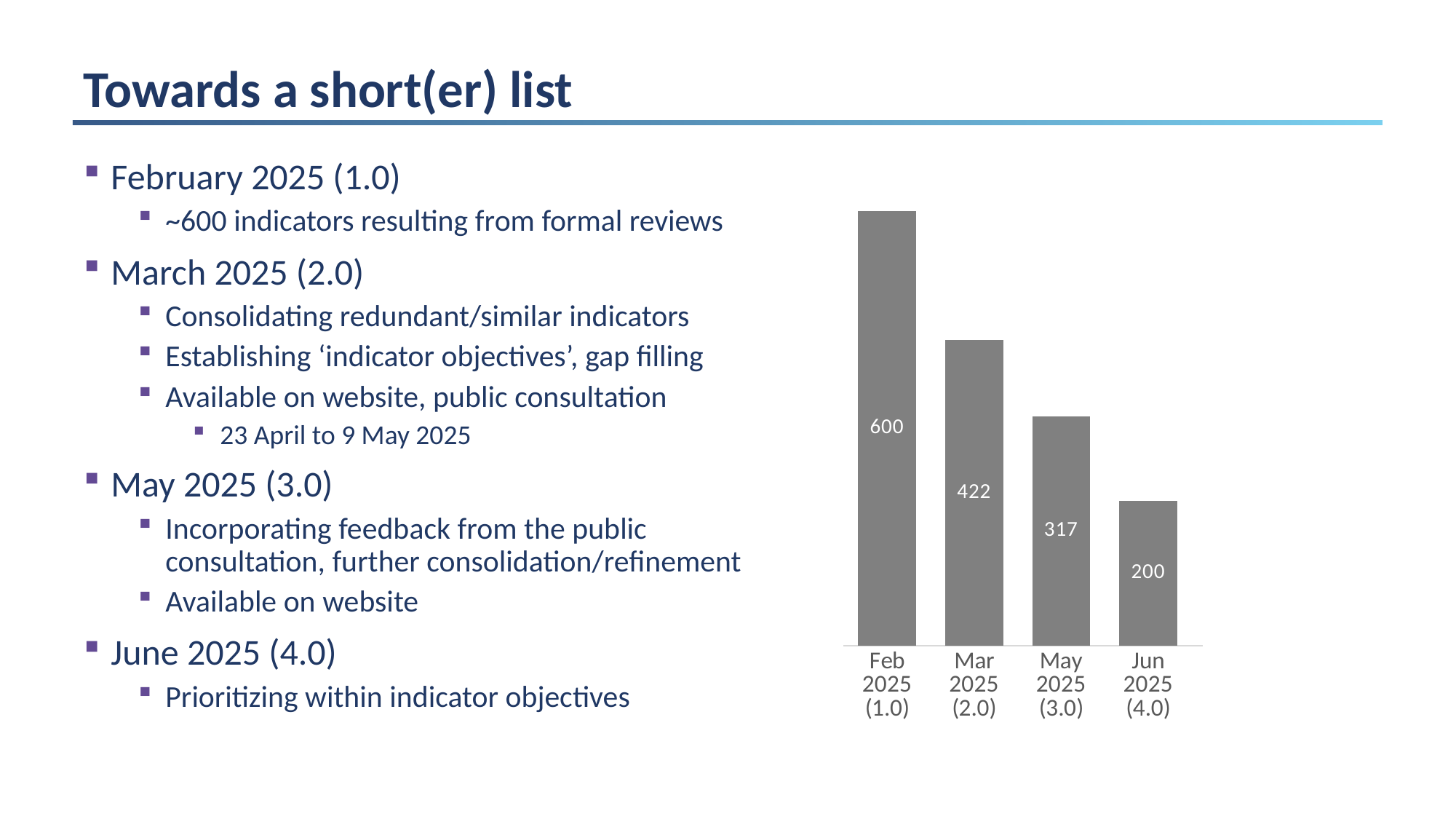
How many categories are shown on the x axis? 4 What is the value for Jun 2025 (4.0)? 200 What is the value for Mar 2025 (2.0)? 422 Do the values rise or fall from Feb 2025 to Jun 2025? Fall Which category has the highest value? Feb 2025 (1.0) What is the difference between the values for Mar 2025 (2.0) and May 2025 (3.0)? 105 What is the difference between the values for Feb 2025 (1.0) and Jun 2025 (4.0)? 400 Which category has the lowest value? Jun 2025 (4.0) What kind of chart is shown on the slide? Bar chart What is the value for May 2025 (3.0)? 317 Which is larger, the value for Mar 2025 (2.0) or the value for May 2025 (3.0)? Mar 2025 (2.0) What is the value for Feb 2025 (1.0)? 600